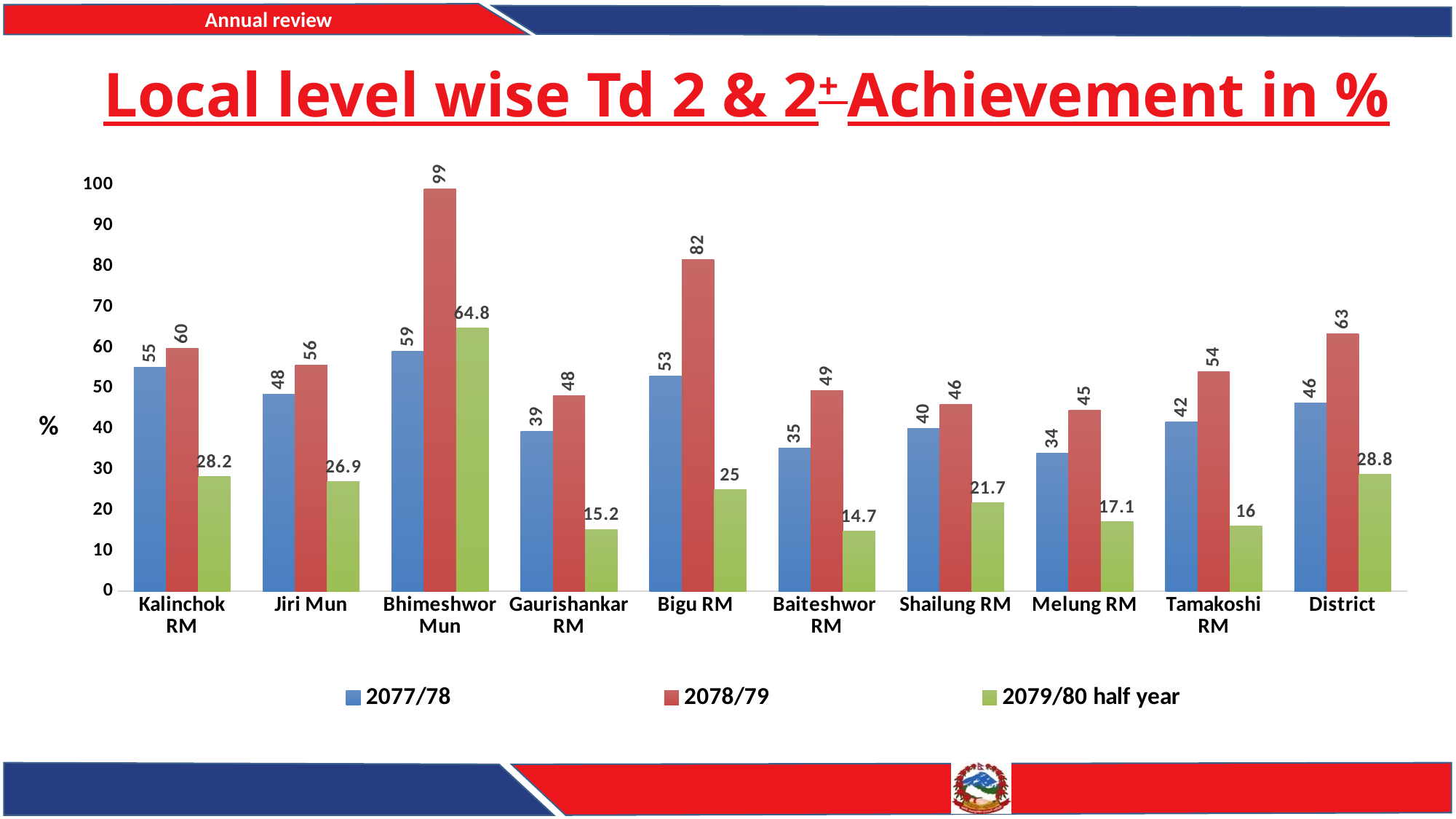
What is the 2077/78 value for Melung RM? 34 What is the 2079/80 half year value for District? 28.8 Which local level has the lowest 2079/80 half year value? Baiteshwor RM Which is larger for Tamakoshi RM: the 2077/78 value or the 2078/79 value? 2078/79 What is the difference between the 2078/79 and 2077/78 values for Bigu RM? 29 How many series does the legend list? 3 What is the 2078/79 value for Bhimeshwor Mun? 99 What kind of chart is shown on the slide? Bar chart Which local level has the highest 2078/79 value? Bhimeshwor Mun What is the 2079/80 half year value for Kalinchok RM? 28.2 Which colour represents the 2079/80 half year series? Green How many local level categories are shown on the x axis? 10